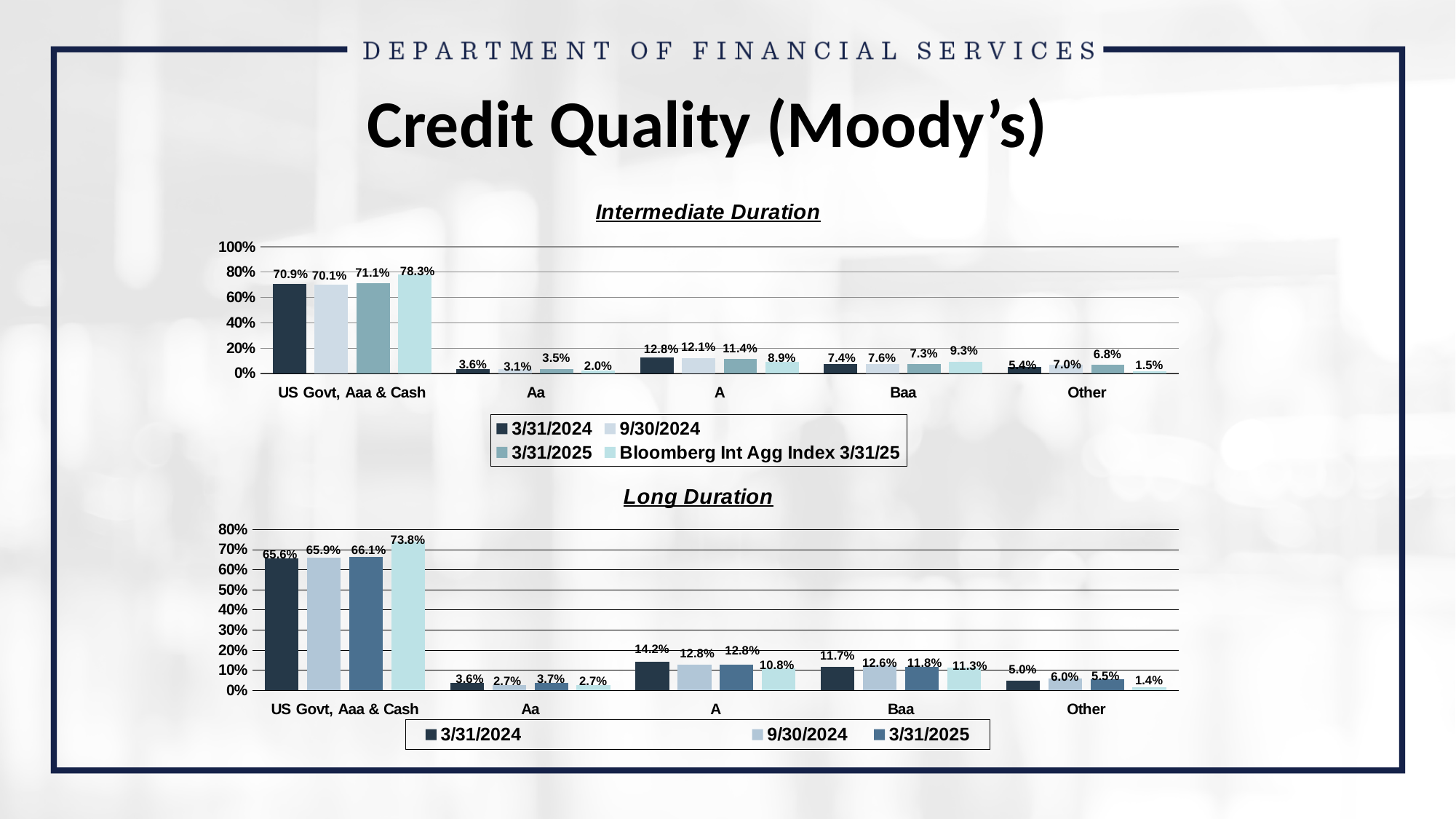
How many series does the legend of the Intermediate Duration chart list? 4 How many categories are shown on the x axis of the Long Duration chart? 5 What type of chart is the Long Duration chart? Bar chart In the Intermediate Duration chart, what is the value for US Govt, Aaa & Cash for the Bloomberg Int Agg Index 3/31/25 series? 78.3% In the Intermediate Duration chart, what is the 3/31/2025 value for the A category? 11.4% In the Long Duration chart, which category has the lowest 3/31/2025 value? Aa In the Long Duration chart, what is the difference between the 3/31/2024 and 9/30/2024 values for A? 1.4% In the Intermediate Duration chart, what is the difference between the 3/31/2024 and 3/31/2025 values for Other? 1.4% In the Long Duration chart, what is the 3/31/2024 value for Other? 5.0% In the Intermediate Duration chart, which is larger for Baa: the 3/31/2025 value or the Bloomberg Int Agg Index 3/31/25 value? Bloomberg Int Agg Index 3/31/25 In the Intermediate Duration chart, which category has the highest 3/31/2024 value? US Govt, Aaa & Cash In the Long Duration chart, what is the 9/30/2024 value for Baa? 12.6%